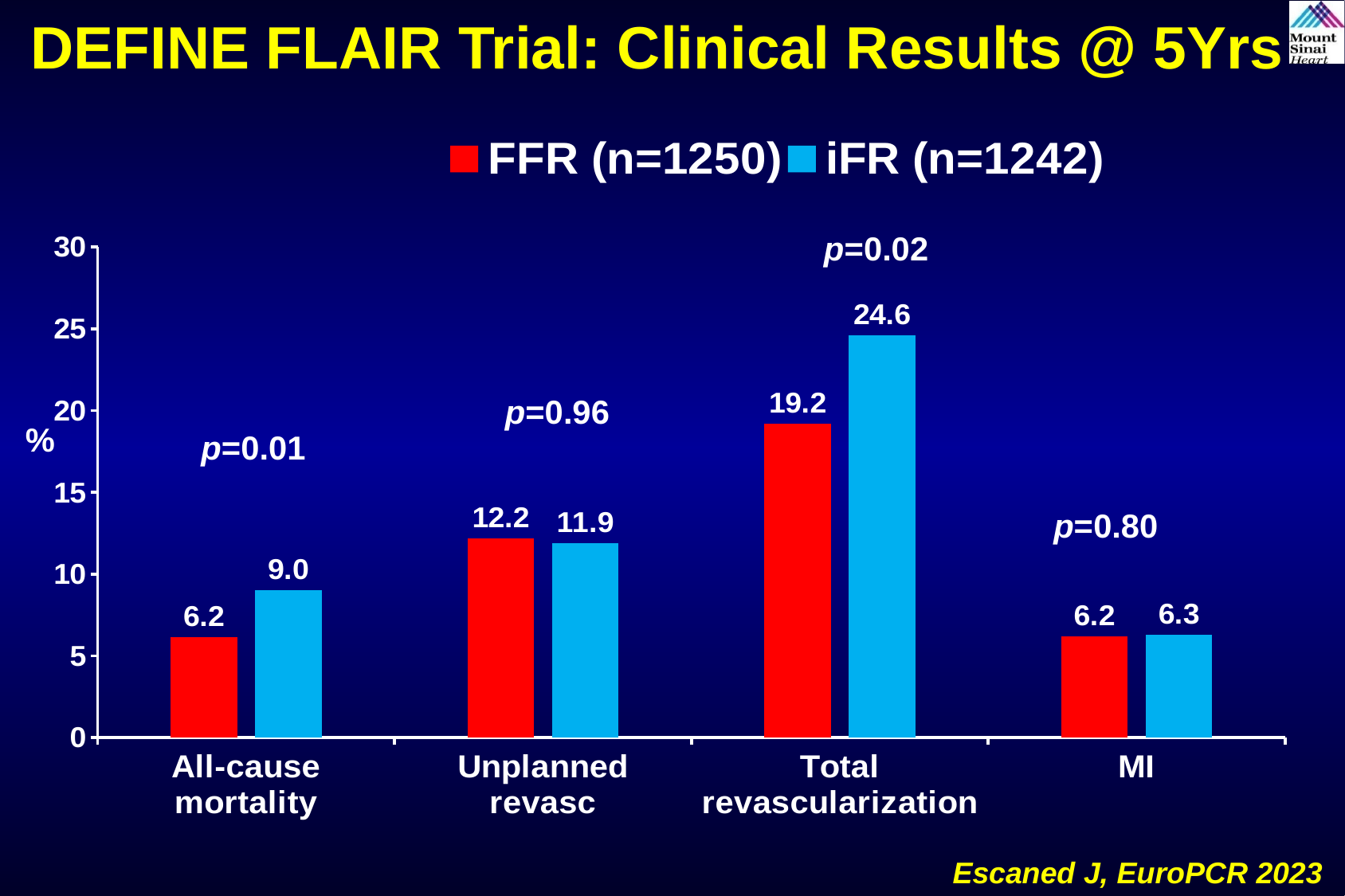
What is the FFR value for MI? 6.2 How many series does the legend list? 2 What is the iFR value for Unplanned revasc? 11.9 Which category has the highest iFR value? Total revascularization What is the iFR value for Total revascularization? 24.6 What is the FFR value for All-cause mortality? 6.2 How many categories are shown on the x axis? 4 What is the difference between the iFR and FFR values for Total revascularization? 5.4 What is the difference between the iFR and FFR values for All-cause mortality? 2.8 For Unplanned revasc, which is larger, the FFR value or the iFR value? FFR What kind of chart is shown on the slide? Bar chart Which category has the lowest FFR value? All-cause mortality and MI (both 6.2)